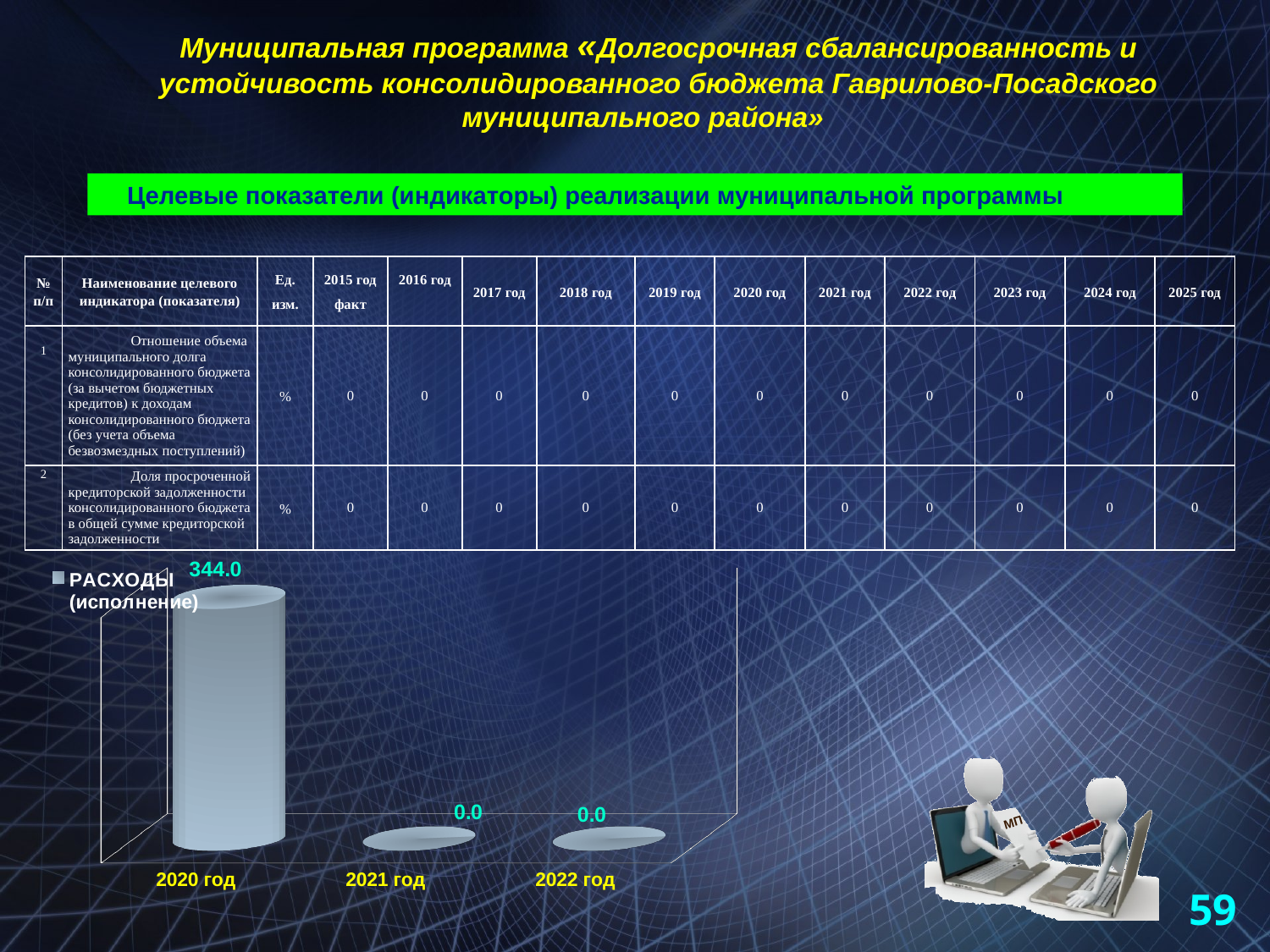
Which year has the highest value in the chart? 2020 год What is the value for 2020 год in the chart? 344.0 Do the values rise or fall from 2020 год to 2022 год? fall What is the difference between the values for 2020 год and 2021 год? 344.0 Which is larger, the value for 2020 год or the value for 2022 год? 2020 год What kind of chart is shown at the bottom of the slide? bar chart How many series does the chart legend list? 1 What is the value for 2022 год in the chart? 0.0 What is the name of the series shown in the chart legend? РАСХОДЫ (исполнение) What is the value for 2021 год in the chart? 0.0 How many categories (years) are shown on the x axis of the chart? 3 What is the total of the values for 2021 год and 2022 год? 0.0